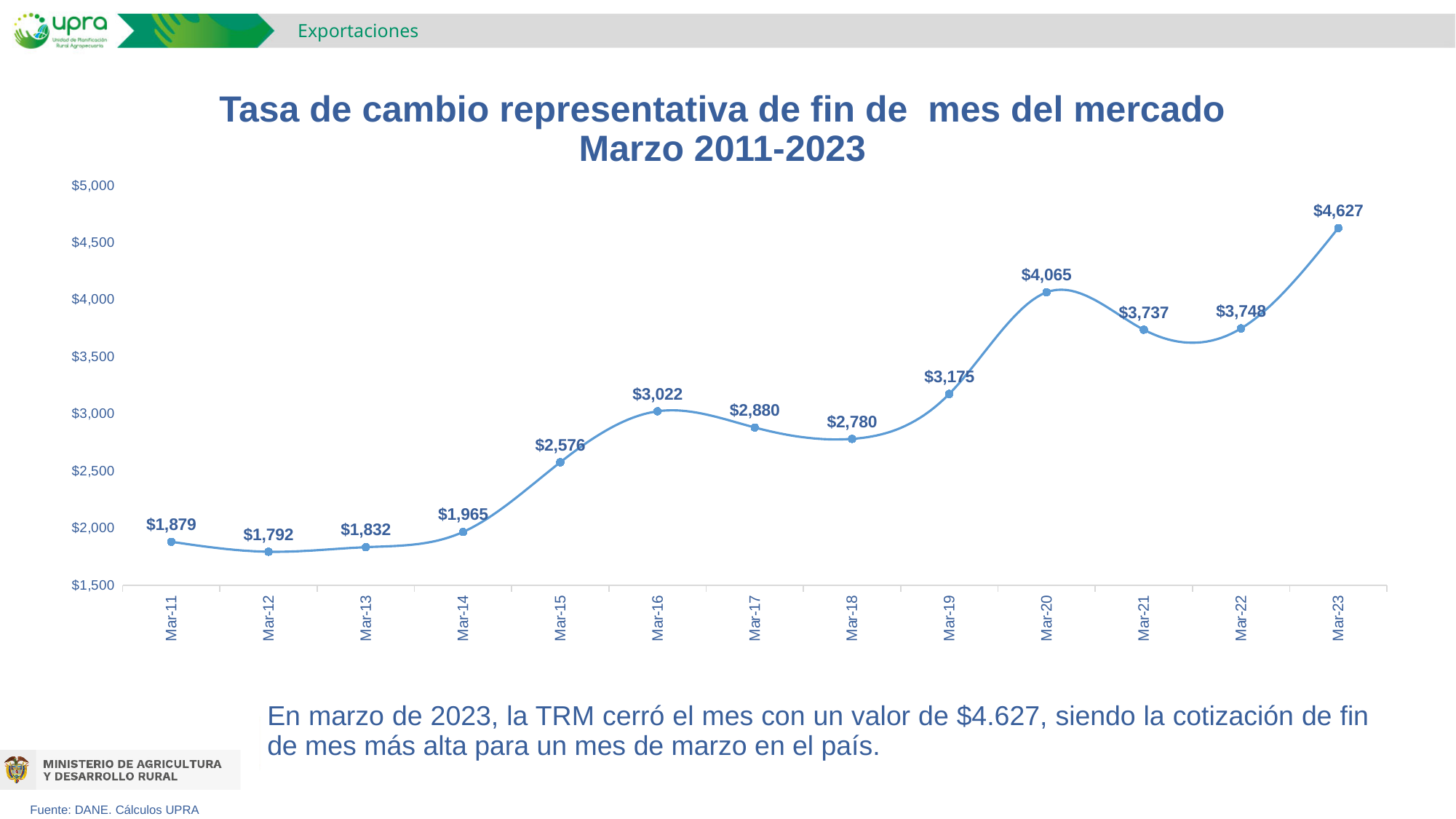
What kind of chart is shown on the slide? line chart Which month has the lowest value? Mar-12 How many data points are plotted on the chart? 13 Is the value for Mar-15 greater or less than $2,500? greater What is the difference between the values for Mar-23 and Mar-22? $879 Which is larger, the value for Mar-17 or the value for Mar-18? Mar-17 What is the difference between the values for Mar-20 and Mar-19? $890 What is the value for Mar-20? $4,065 What is the value for Mar-16? $3,022 Do the values rise or fall from Mar-18 to Mar-20? rise What is the value for Mar-12? $1,792 Which month has the highest value? Mar-23